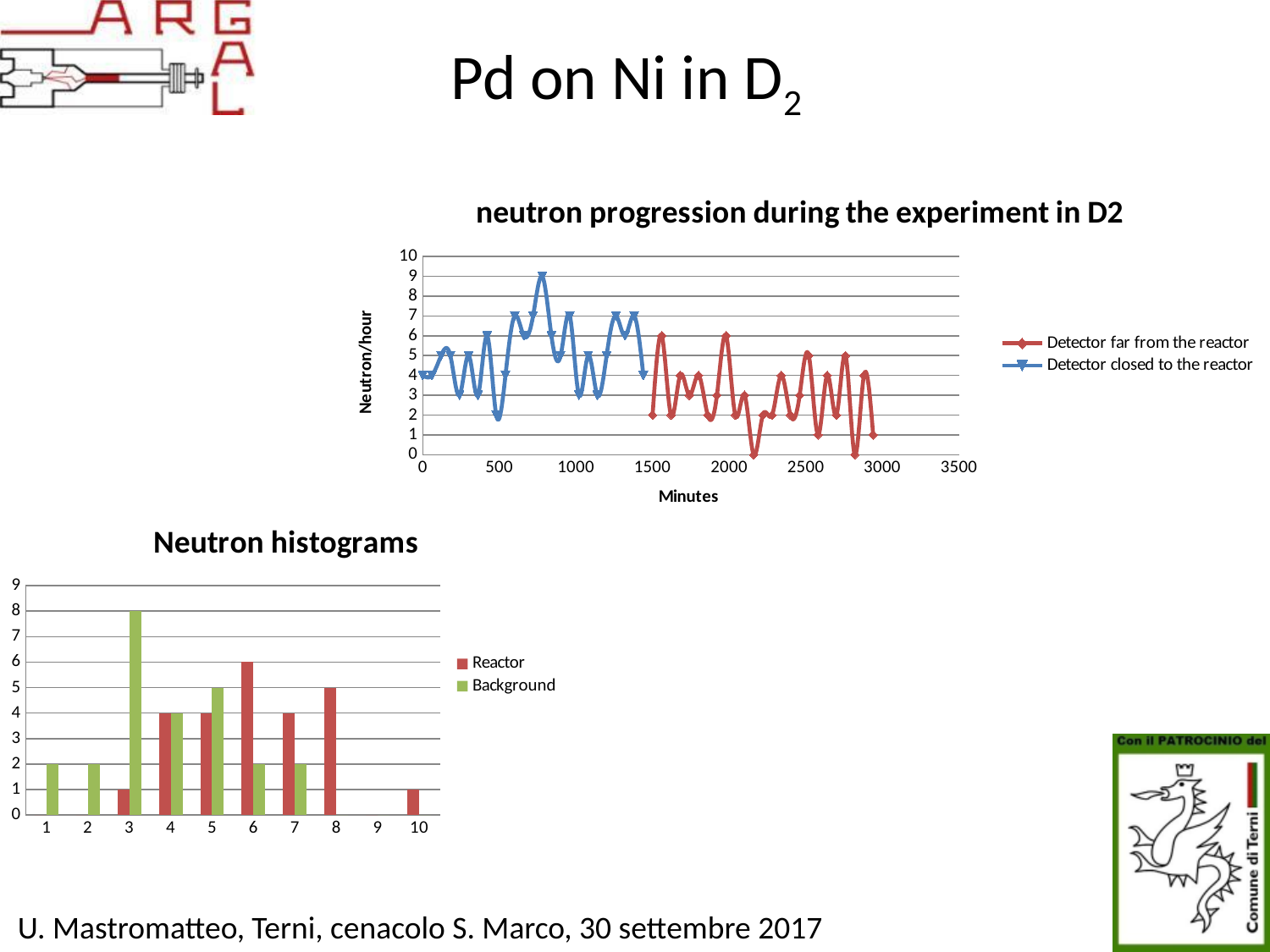
How many series does the legend of the 'neutron progression during the experiment in D2' chart list? 2 In the 'neutron progression during the experiment in D2' chart, which series is plotted in blue? Detector closed to the reactor In the 'Neutron histograms' chart, which is larger for category 5, the Reactor value or the Background value? Background What type of chart is the 'neutron progression during the experiment in D2' chart? line chart In the 'neutron progression during the experiment in D2' chart, what is the highest value reached by the 'Detector closed to the reactor' series? 9 In the 'Neutron histograms' chart, what is the difference between the Background value and the Reactor value for category 3? 7 In the 'Neutron histograms' chart, which category has the highest Reactor value? 6 In the 'neutron progression during the experiment in D2' chart, what is the label of the y axis? Neutron/hour What type of chart is the 'Neutron histograms' chart? bar chart In the 'Neutron histograms' chart, what is the Background value for category 3? 8 In the 'Neutron histograms' chart, what is the Reactor value for category 6? 6 In the 'Neutron histograms' chart, which category has the highest Background value? 3